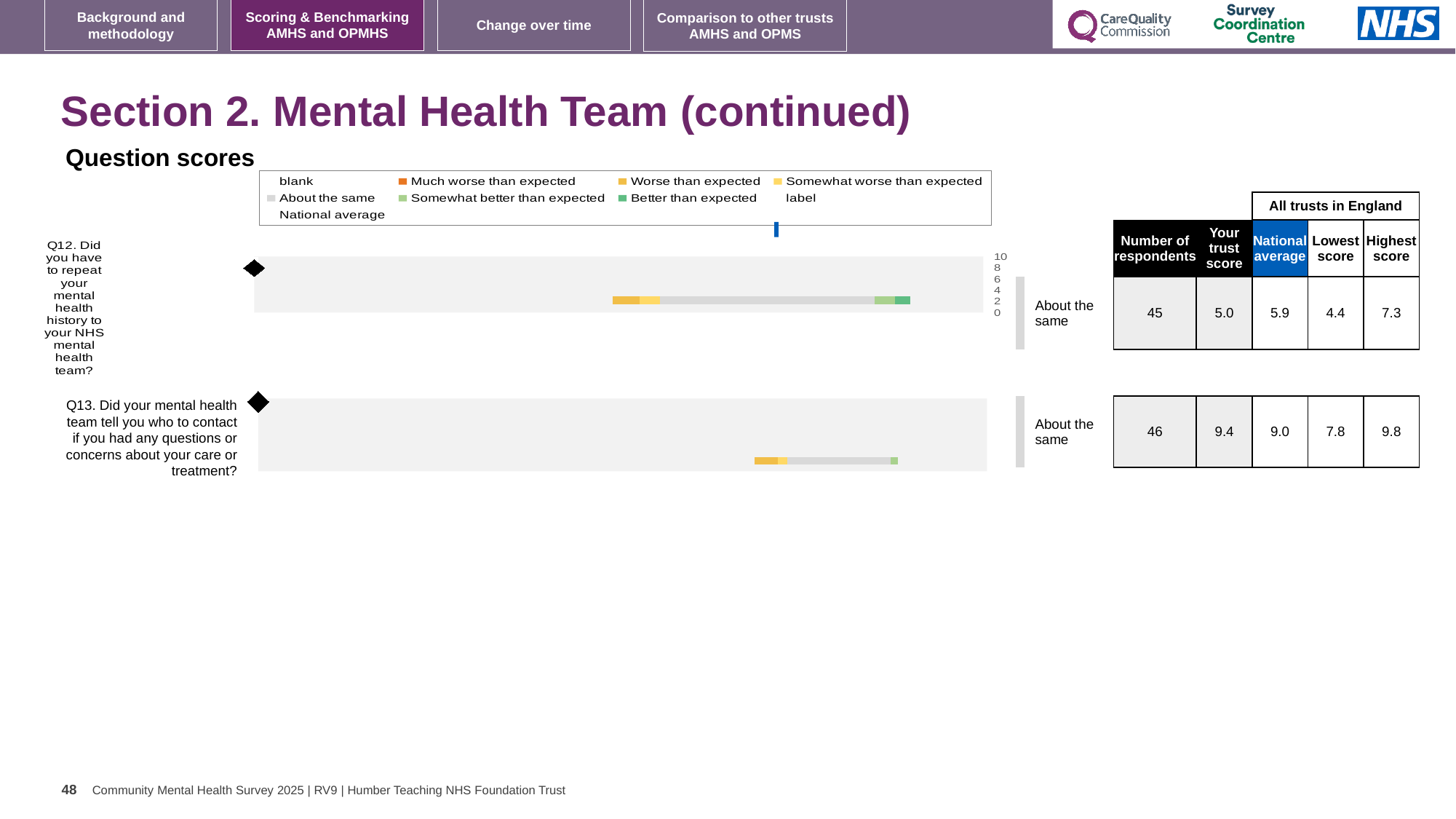
Which question has the higher trust score, Q12 or Q13? Q13 For the Q13 chart, what is the trust's score shown in the table? 9.4 What rating label is shown next to the Q13 chart? About the same What kind of chart is used for Q12 and Q13 on this slide? Bar chart For the Q12 chart, how many respondents are shown? 45 For Q13, what is the difference between the highest and lowest scores among all trusts in England? 2.0 For the Q12 chart, what is the trust's score shown in the table? 5.0 How many questions (charts) are shown on this slide? 2 For the Q13 chart, what is the highest score among all trusts in England? 9.8 For Q12, what is the difference between the national average and the trust score? 0.9 In the legend, what colour represents 'Better than expected'? Green For the Q12 chart, what is the national average shown? 5.9